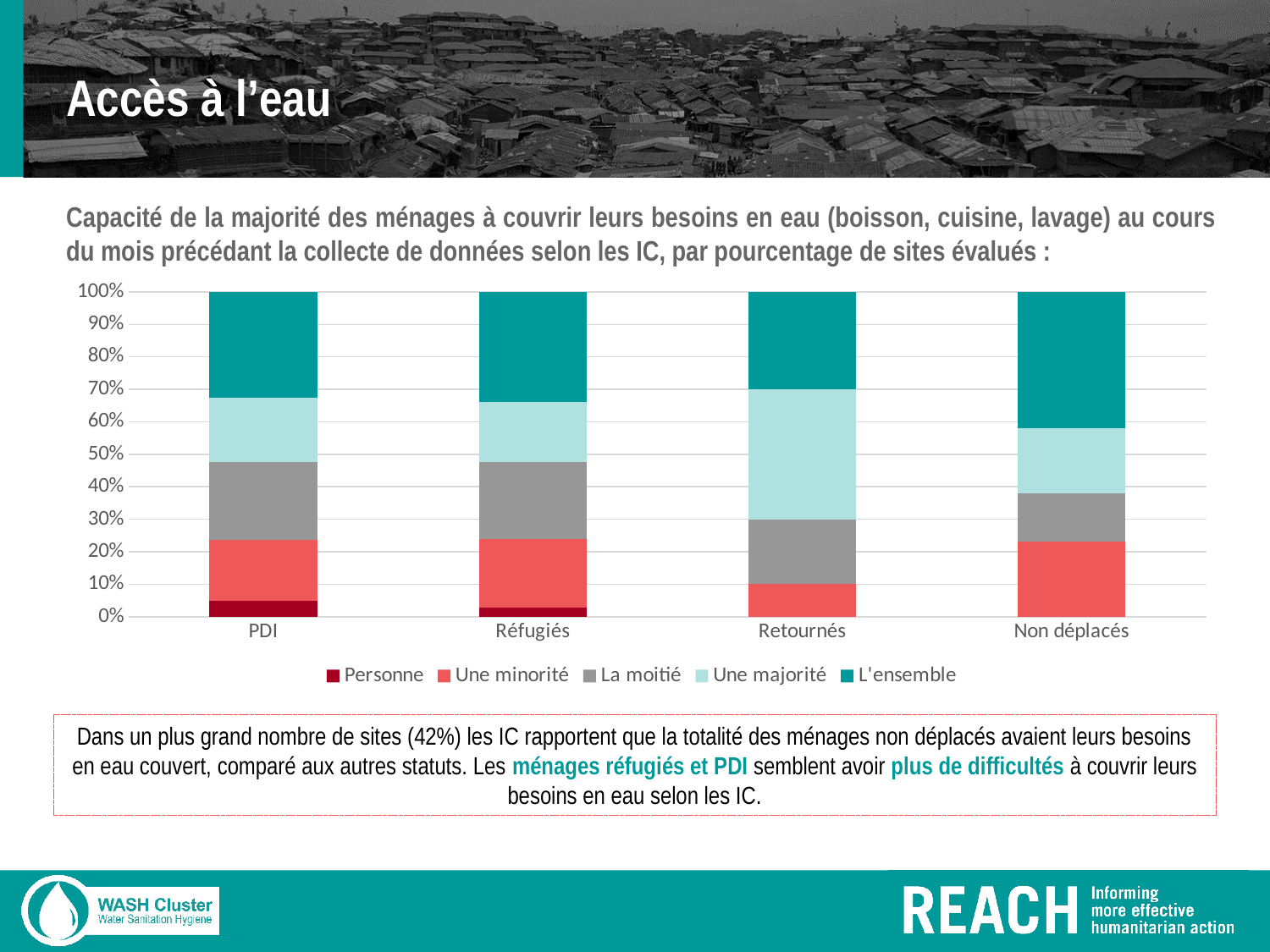
How many series does the chart legend list? 5 Is the 'Personne' value for PDI greater or less than 10%? less Is the 'Une majorité' segment larger for Retournés or for PDI? Retournés How many categories are shown on the x axis of the chart? 4 What is the total of each stacked bar in the chart? 100% Is the 'La moitié' value for Réfugiés greater or less than 20%? greater Which category has the largest 'Personne' segment? PDI What kind of chart is shown on the slide? Stacked bar chart Which category has the largest 'L'ensemble' segment? Non déplacés Which category has the largest 'Une majorité' segment? Retournés Is the 'Une majorité' value for Retournés greater or less than 30%? greater Which legend entry is shown in dark teal? L'ensemble